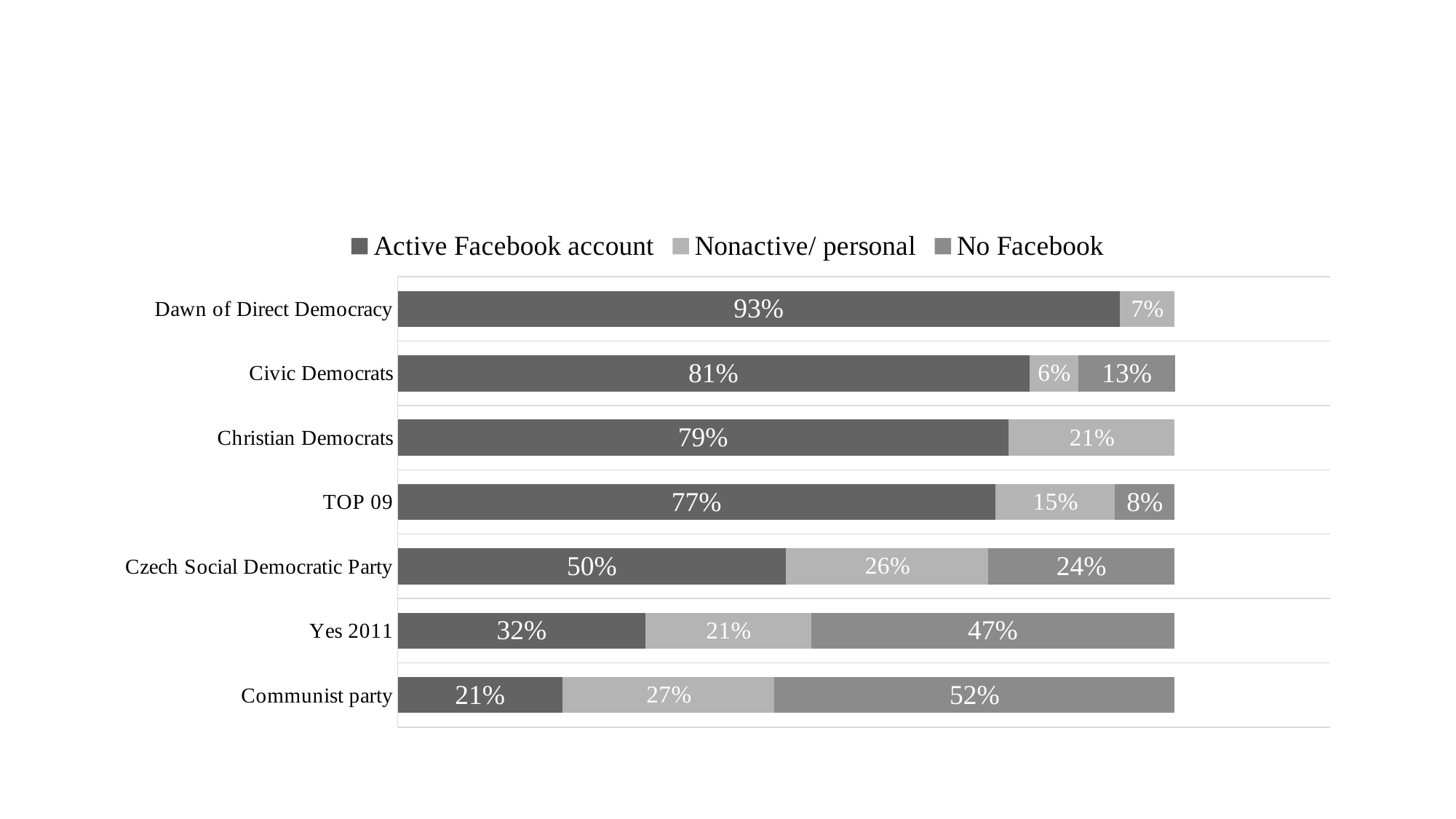
Which series is listed first in the legend? Active Facebook account How many parties are shown in the chart? 7 How many series does the legend list? 3 Which party has the lowest Active Facebook account value? Communist party What is the total of the stacked bar for TOP 09? 100% Which party has the highest Active Facebook account value? Dawn of Direct Democracy What is the difference between the No Facebook values for Communist party and Yes 2011? 5% What kind of chart is shown on the slide? Stacked bar chart What is the Active Facebook account value for Civic Democrats? 81% What is the Nonactive/ personal value for Czech Social Democratic Party? 26% Which is larger: the Nonactive/ personal value for TOP 09 or for Christian Democrats? Christian Democrats What is the No Facebook value for Yes 2011? 47%